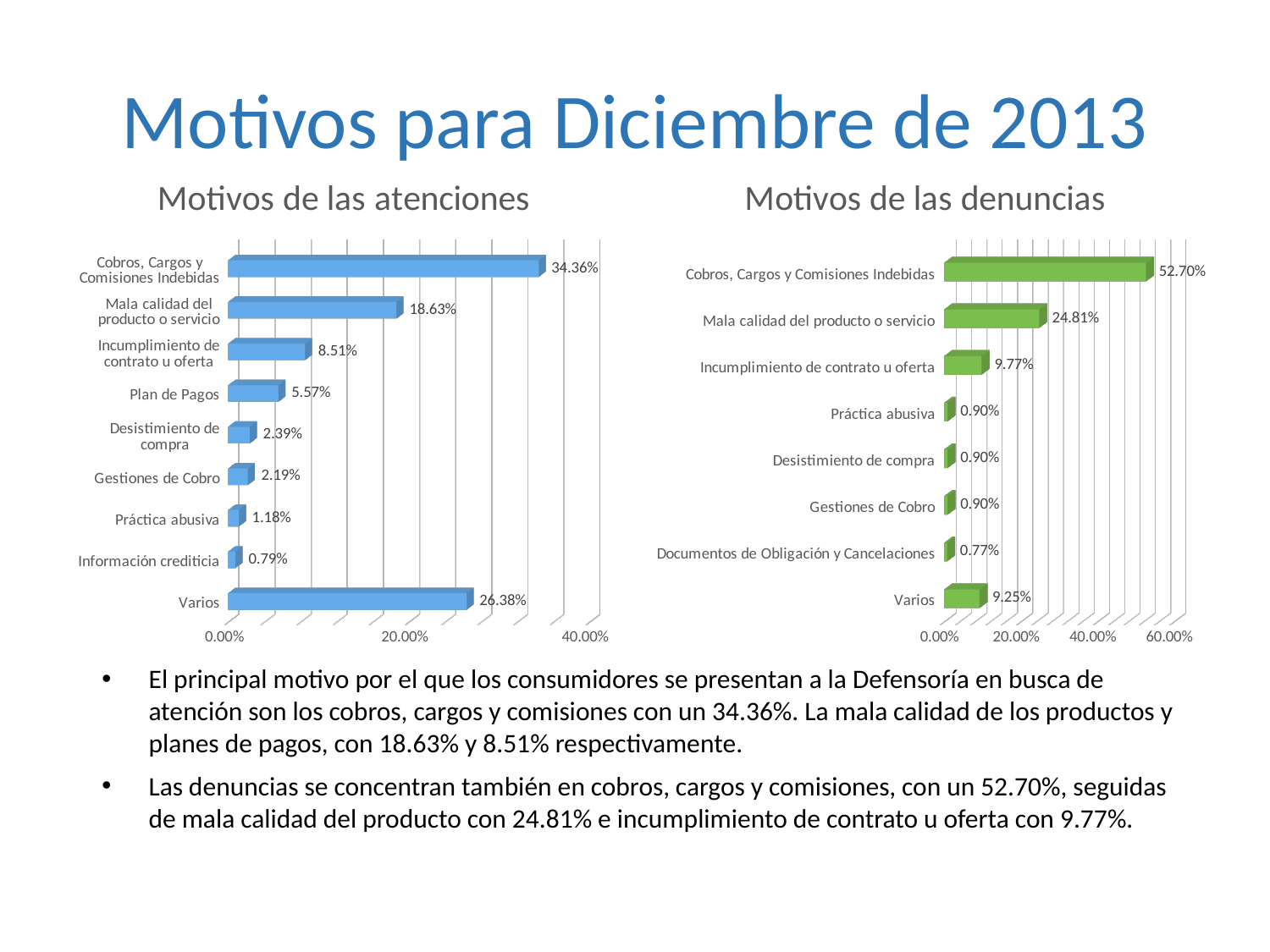
How many categories are shown in the 'Motivos de las atenciones' chart? 9 In the 'Motivos de las atenciones' chart, which category has the lowest value? Información crediticia What colour are the bars in the 'Motivos de las atenciones' chart? Blue In the 'Motivos de las atenciones' chart, is the value for Varios greater or less than 20.00%? greater What kind of chart is 'Motivos de las denuncias'? Bar chart In the 'Motivos de las atenciones' chart, what is the value for Cobros, Cargos y Comisiones Indebidas? 34.36% In the 'Motivos de las denuncias' chart, which category has the highest value? Cobros, Cargos y Comisiones Indebidas In the 'Motivos de las atenciones' chart, what is the difference between Mala calidad del producto o servicio and Incumplimiento de contrato u oferta? 10.12% In the 'Motivos de las denuncias' chart, which is larger: Varios or Incumplimiento de contrato u oferta? Incumplimiento de contrato u oferta In the 'Motivos de las denuncias' chart, what is the value for Documentos de Obligación y Cancelaciones? 0.77% How many categories are shown in the 'Motivos de las denuncias' chart? 8 In the 'Motivos de las denuncias' chart, what is the value for Mala calidad del producto o servicio? 24.81%